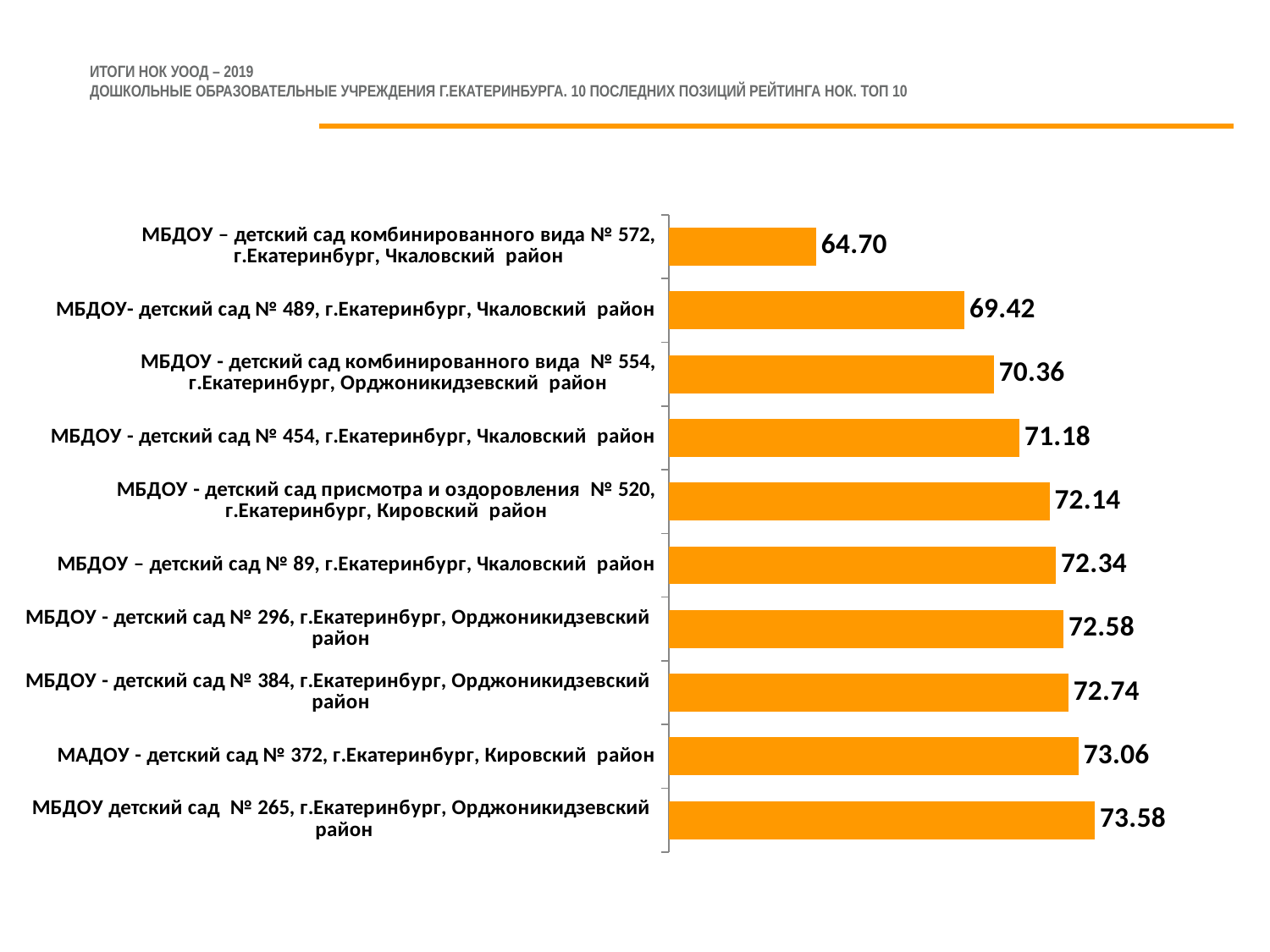
What value is shown for МАДОУ - детский сад № 372, г.Екатеринбург, Кировский район? 73.06 What value is shown for МБДОУ - детский сад № 454, г.Екатеринбург, Чкаловский район? 71.18 What value is shown for МБДОУ – детский сад комбинированного вида № 572, г.Екатеринбург, Чкаловский район? 64.70 What value is shown for МБДОУ - детский сад № 384, г.Екатеринбург, Орджоникидзевский район? 72.74 Which institution has the lowest value on the chart? МБДОУ – детский сад комбинированного вида № 572, г.Екатеринбург, Чкаловский район What is the difference between the values for МБДОУ- детский сад № 489 and МБДОУ - детский сад комбинированного вида № 554? 0.94 What kind of chart is shown on the slide? Bar chart How many institutions are shown on the chart? 10 Which institution has the highest value on the chart? МБДОУ детский сад № 265, г.Екатеринбург, Орджоникидзевский район What colour are the bars on the chart? Orange What is the difference between the values for МБДОУ детский сад № 265 (Орджоникидзевский район) and МБДОУ – детский сад комбинированного вида № 572 (Чкаловский район)? 8.88 Which has a larger value: МБДОУ - детский сад присмотра и оздоровления № 520 or МБДОУ - детский сад № 454? МБДОУ - детский сад присмотра и оздоровления № 520